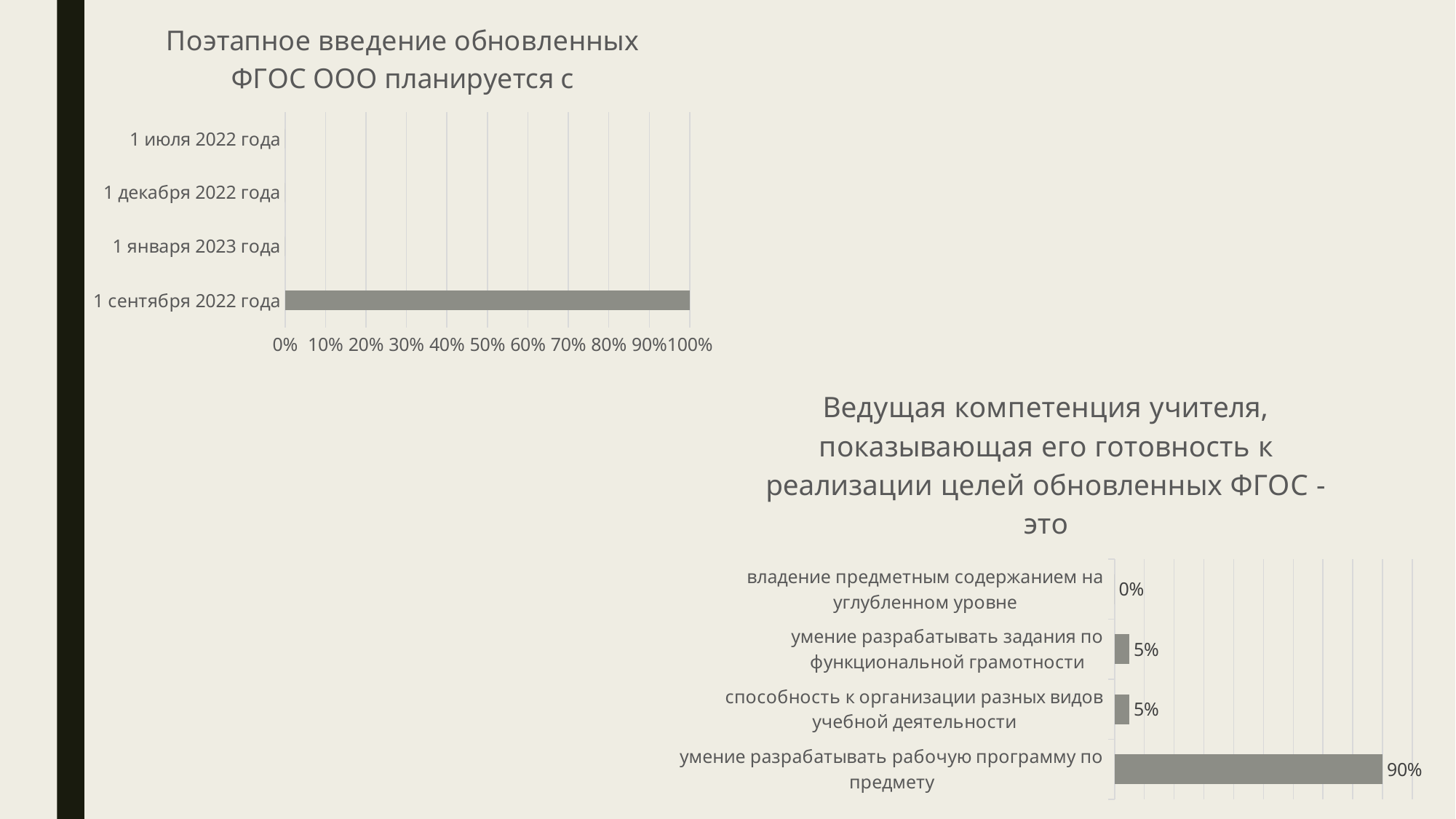
What kind of chart is the one titled "Поэтапное введение обновленных ФГОС ООО планируется с"? bar chart In the chart titled "Ведущая компетенция учителя, показывающая его готовность к реализации целей обновленных ФГОС - это", what is the value for "умение разрабатывать рабочую программу по предмету"? 90% In the chart titled "Ведущая компетенция учителя, показывающая его готовность к реализации целей обновленных ФГОС - это", how many categories are shown? 4 In the chart titled "Ведущая компетенция учителя, показывающая его готовность к реализации целей обновленных ФГОС - это", what is the value for "умение разрабатывать задания по функциональной грамотности"? 5% In the chart titled "Поэтапное введение обновленных ФГОС ООО планируется с", is the value for 1 сентября 2022 года greater or less than 50%? greater In the chart titled "Поэтапное введение обновленных ФГОС ООО планируется с", how many categories are shown on the vertical axis? 4 In the chart titled "Ведущая компетенция учителя, показывающая его готовность к реализации целей обновленных ФГОС - это", which category has the lowest value? владение предметным содержанием на углубленном уровне In the chart titled "Ведущая компетенция учителя, показывающая его готовность к реализации целей обновленных ФГОС - это", which is larger: the value for "умение разрабатывать рабочую программу по предмету" or the value for "умение разрабатывать задания по функциональной грамотности"? умение разрабатывать рабочую программу по предмету In the chart titled "Ведущая компетенция учителя, показывающая его готовность к реализации целей обновленных ФГОС - это", what is the value for "владение предметным содержанием на углубленном уровне"? 0% In the chart titled "Ведущая компетенция учителя, показывающая его готовность к реализации целей обновленных ФГОС - это", what is the difference between the value for "умение разрабатывать рабочую программу по предмету" and the value for "способность к организации разных видов учебной деятельности"? 85% In the chart titled "Поэтапное введение обновленных ФГОС ООО планируется с", which category has the highest value? 1 сентября 2022 года In the chart titled "Поэтапное введение обновленных ФГОС ООО планируется с", what is the value for 1 сентября 2022 года? 100%